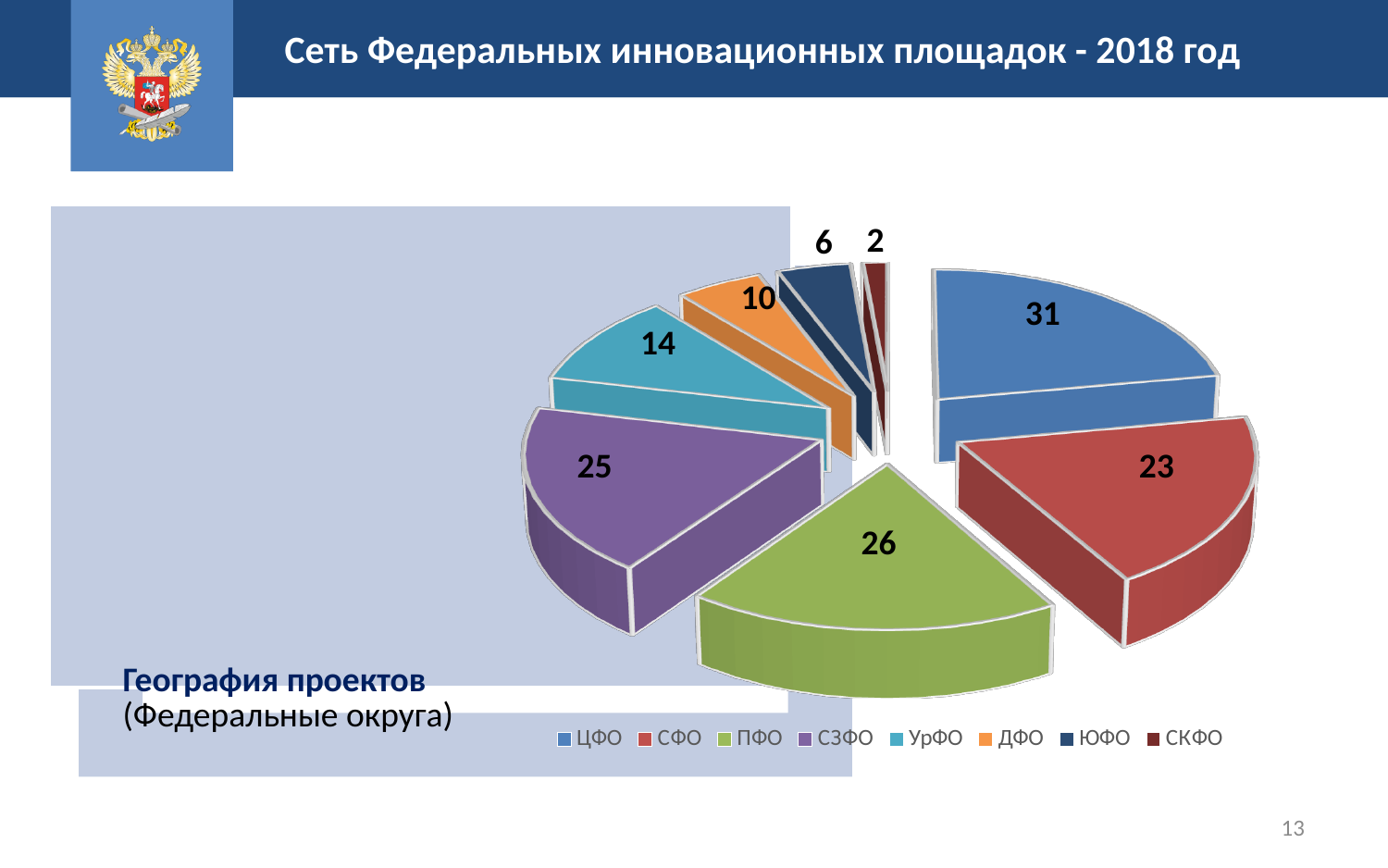
What is the value for ДФО in the pie chart? 10 Which federal district has the largest slice in the pie chart? ЦФО What kind of chart is shown on the slide? Pie chart What is the difference between the values for УрФО and ЮФО? 8 What is the value for ЦФО in the pie chart? 31 Which is larger, the value for ПФО or the value for СЗФО? ПФО Which federal district has the smallest slice in the pie chart? СКФО How many entries does the legend list? 8 How many slices does the pie chart have? 8 What is the difference between the values for ЦФО and СФО? 8 What is the total of all the values shown in the pie chart? 137 What is the value for СЗФО in the pie chart? 25